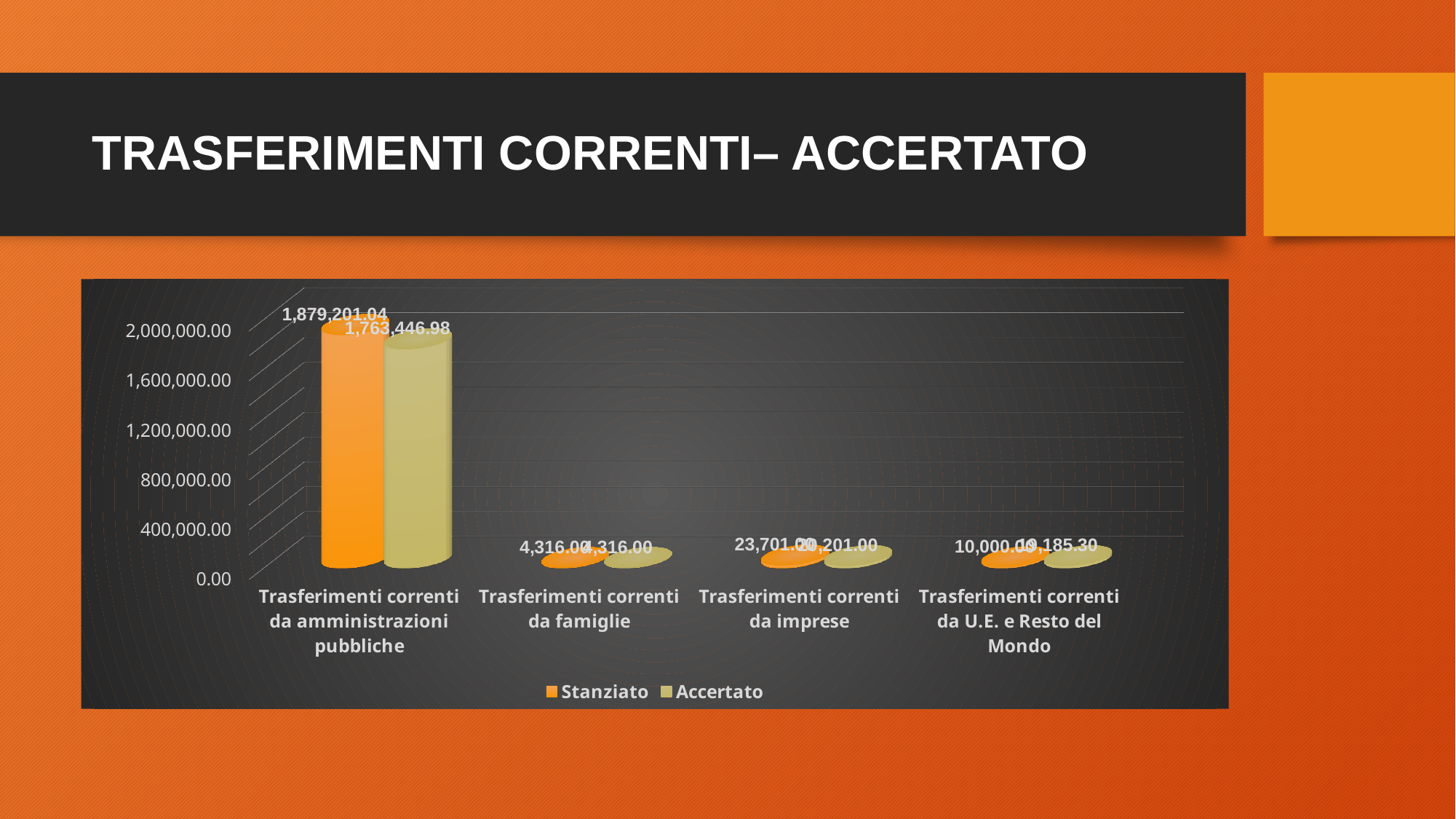
For Trasferimenti correnti da amministrazioni pubbliche, which is larger: Stanziato or Accertato? Stanziato What kind of chart is shown on the slide? Bar chart How many categories are shown on the x axis? 4 What is the difference between the Stanziato and Accertato values for Trasferimenti correnti da amministrazioni pubbliche? 115,754.06 Which category has the highest Accertato value? Trasferimenti correnti da amministrazioni pubbliche What is the Stanziato value for Trasferimenti correnti da amministrazioni pubbliche? 1,879,201.04 How many series does the legend list? 2 What is the Accertato value for Trasferimenti correnti da U.E. e Resto del Mondo? 19,185.30 Which category has the lowest Stanziato value? Trasferimenti correnti da famiglie What is the Accertato value for Trasferimenti correnti da famiglie? 4,316.00 Is the Accertato value for Trasferimenti correnti da amministrazioni pubbliche greater or less than 1,600,000.00? greater What is the Accertato value for Trasferimenti correnti da amministrazioni pubbliche? 1,763,446.98